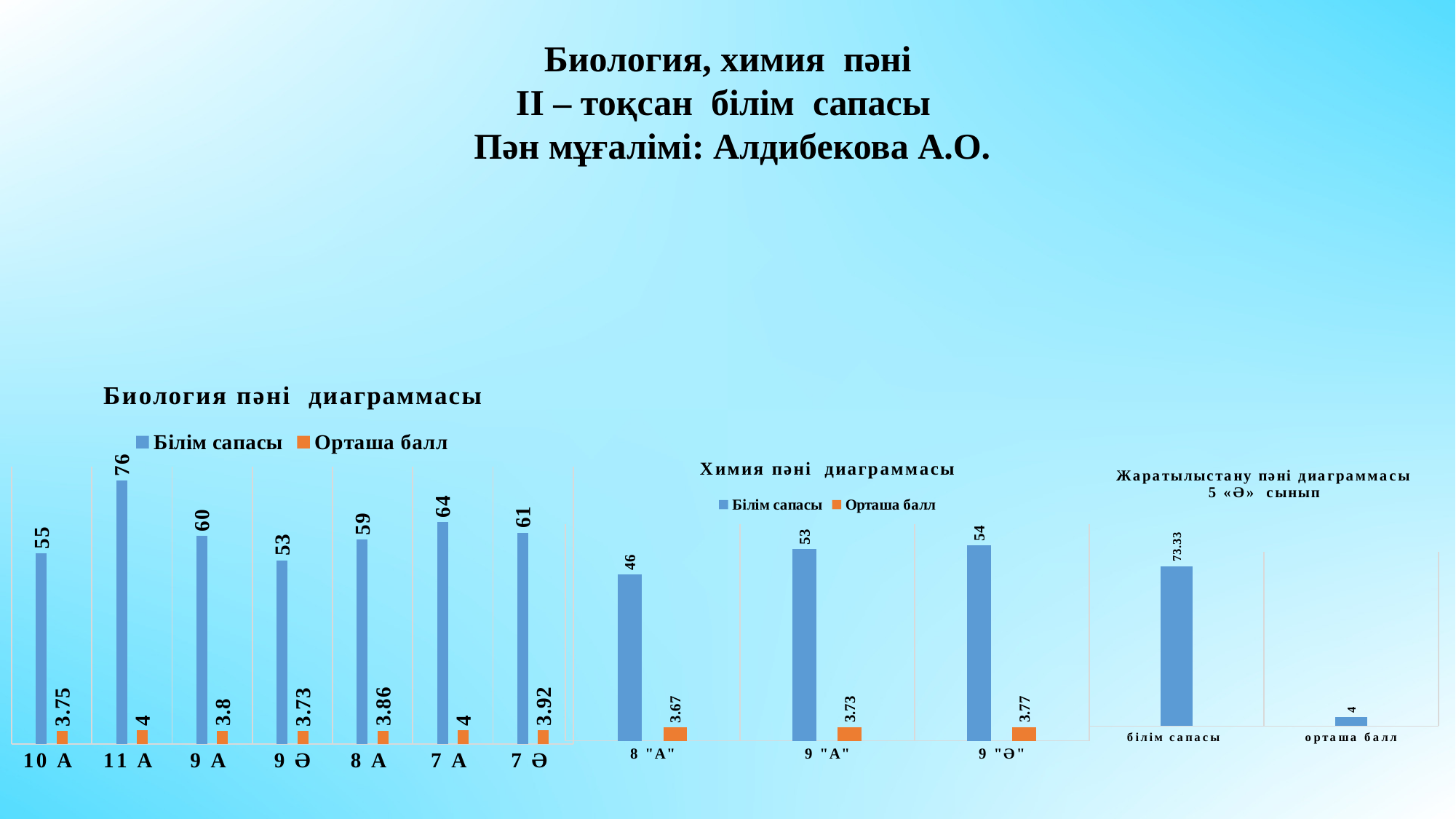
In the 'Биология пәні диаграммасы' chart, what is the difference between the Білім сапасы values for 11 А and 10 А? 21 In the 'Биология пәні диаграммасы' chart, what is the Білім сапасы value for 11 А? 76 In the 'Биология пәні диаграммасы' chart, what is the Орташа балл value for 8 А? 3.86 In the 'Химия пәні диаграммасы' chart, what is the Білім сапасы value for 8 "А"? 46 In the 'Химия пәні диаграммасы' chart, what is the Орташа балл value for 9 "Ә"? 3.77 In the 'Биология пәні диаграммасы' chart, which class has the lowest Білім сапасы value? 9 Ә In the 'Химия пәні диаграммасы' chart, which class has the lowest Білім сапасы value? 8 "А" In the 'Биология пәні диаграммасы' chart, how many classes are shown on the x axis? 7 In the 'Биология пәні диаграммасы' chart, which class has the highest Білім сапасы value? 11 А What kind of chart is the 'Жаратылыстану пәні диаграммасы 5 «Ә» сынып' chart? Bar chart In the 'Жаратылыстану пәні диаграммасы 5 «Ә» сынып' chart, what is the value for білім сапасы? 73.33 In the 'Химия пәні диаграммасы' chart, how many series does the legend list? 2